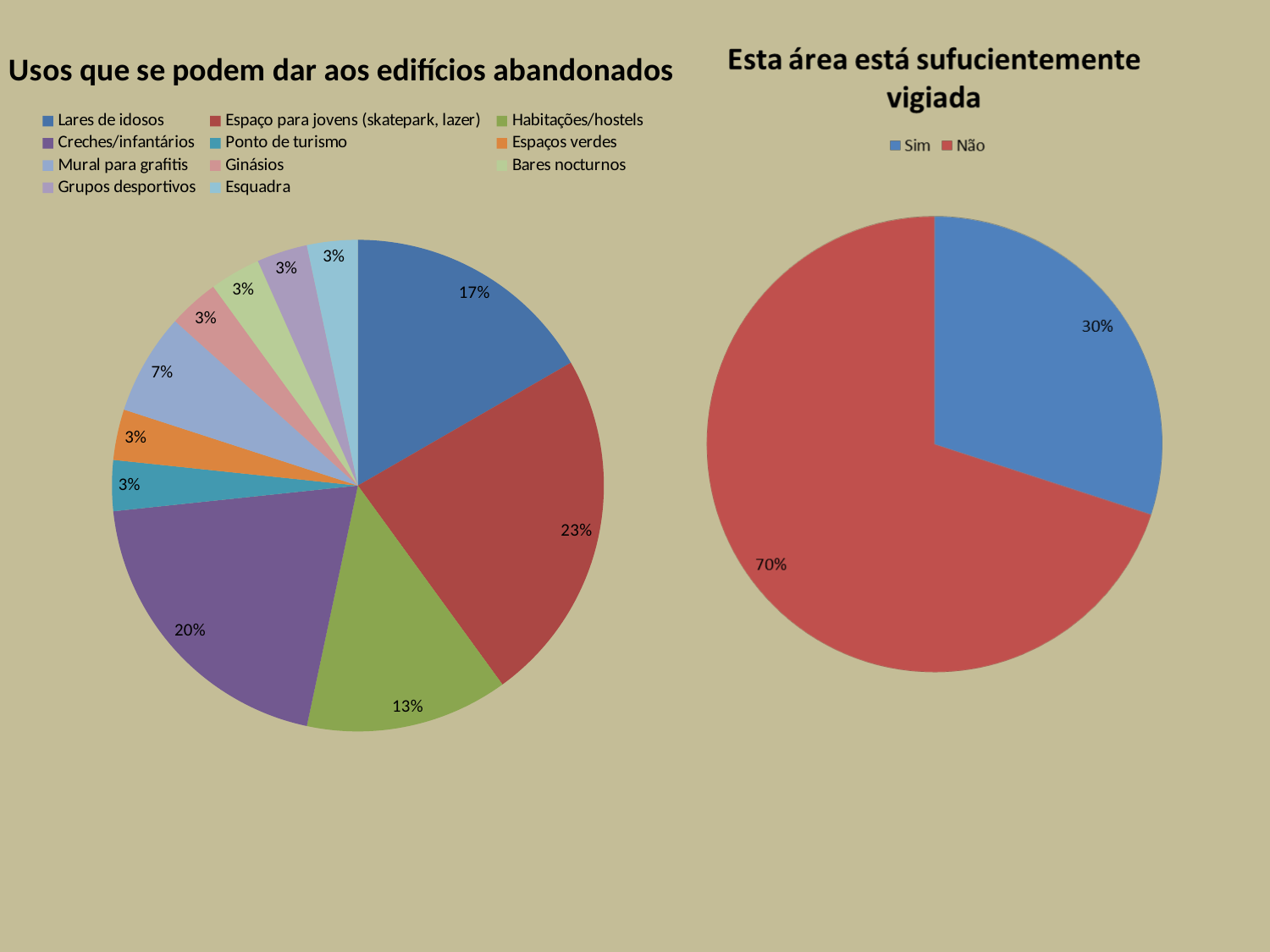
In the chart 'Usos que se podem dar aos edifícios abandonados', which category has the largest share? Espaço para jovens (skatepark, lazer) In the chart 'Usos que se podem dar aos edifícios abandonados', what share does 'Mural para grafitis' have? 7% In the chart 'Esta área está sufucientemente vigiada', what share does 'Não' have? 70% In the chart 'Usos que se podem dar aos edifícios abandonados', what share does 'Creches/infantários' have? 20% In the chart 'Esta área está sufucientemente vigiada', what share does 'Sim' have? 30% How many categories does the legend of the chart 'Usos que se podem dar aos edifícios abandonados' list? 11 What kind of chart is 'Usos que se podem dar aos edifícios abandonados'? Pie chart In the chart 'Esta área está sufucientemente vigiada', what is the difference between the 'Não' and 'Sim' shares? 40% In the chart 'Usos que se podem dar aos edifícios abandonados', what share does 'Espaço para jovens (skatepark, lazer)' have? 23% In the chart 'Usos que se podem dar aos edifícios abandonados', which is larger: 'Lares de idosos' or 'Creches/infantários'? Creches/infantários In the chart 'Usos que se podem dar aos edifícios abandonados', what is the difference between the shares of 'Espaço para jovens (skatepark, lazer)' and 'Habitações/hostels'? 10% In the chart 'Esta área está sufucientemente vigiada', which colour represents 'Sim'? Blue